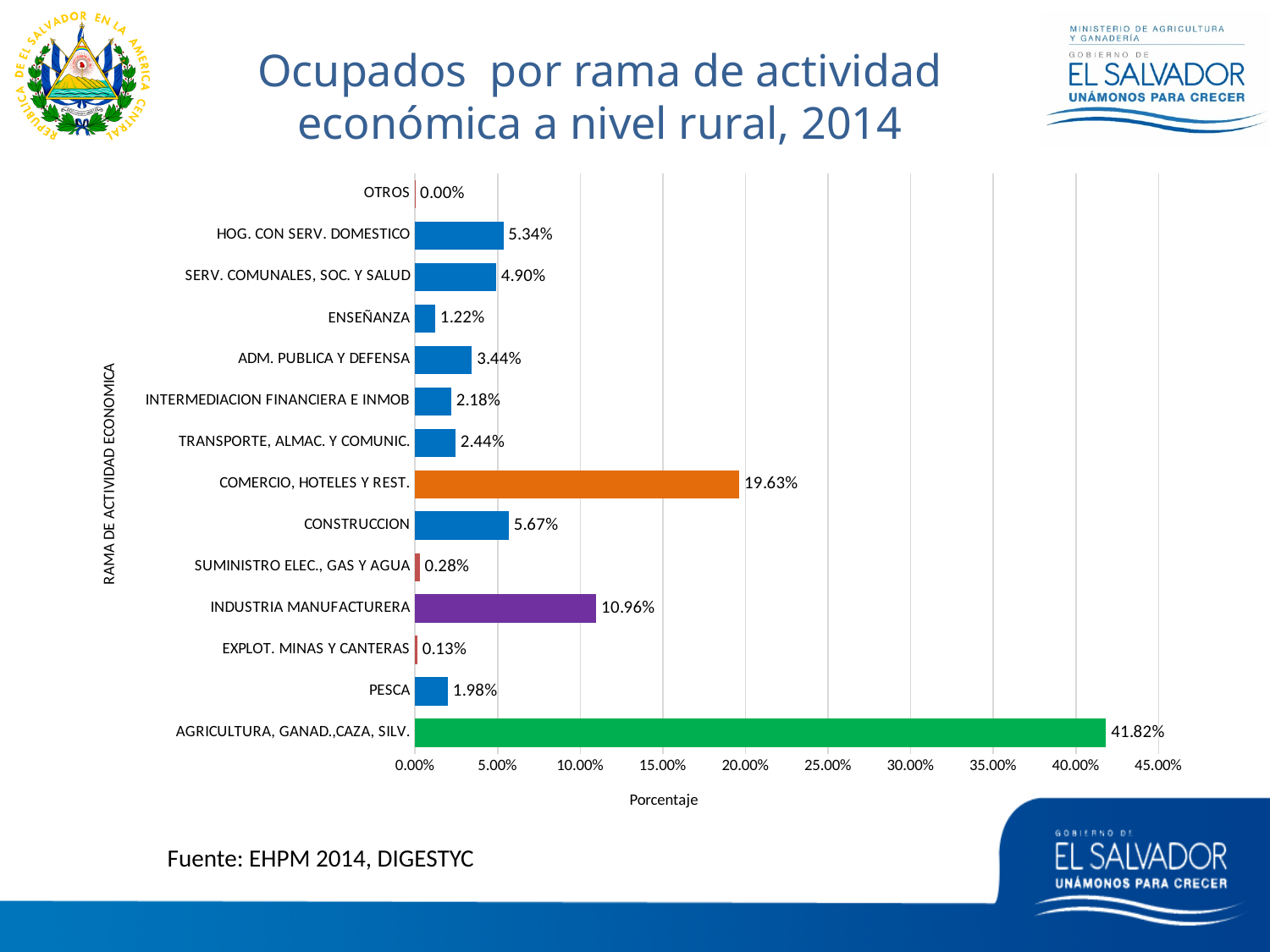
What is the value for AGRICULTURA, GANAD.,CAZA, SILV.? 41.82% Which category has the highest value? AGRICULTURA, GANAD.,CAZA, SILV. Which is larger, the value for CONSTRUCCION or the value for HOG. CON SERV. DOMESTICO? CONSTRUCCION What is the value for INDUSTRIA MANUFACTURERA? 10.96% Which category has the lowest value? OTROS What kind of chart is shown on the slide? bar chart What is the title of the chart? Ocupados por rama de actividad económica a nivel rural, 2014 What is the difference between the values for AGRICULTURA, GANAD.,CAZA, SILV. and COMERCIO, HOTELES Y REST.? 22.19% What is the value for COMERCIO, HOTELES Y REST.? 19.63% Is the value for INDUSTRIA MANUFACTURERA greater or less than 10.00%? greater What is the value for ENSEÑANZA? 1.22% How many categories are shown in the chart? 14